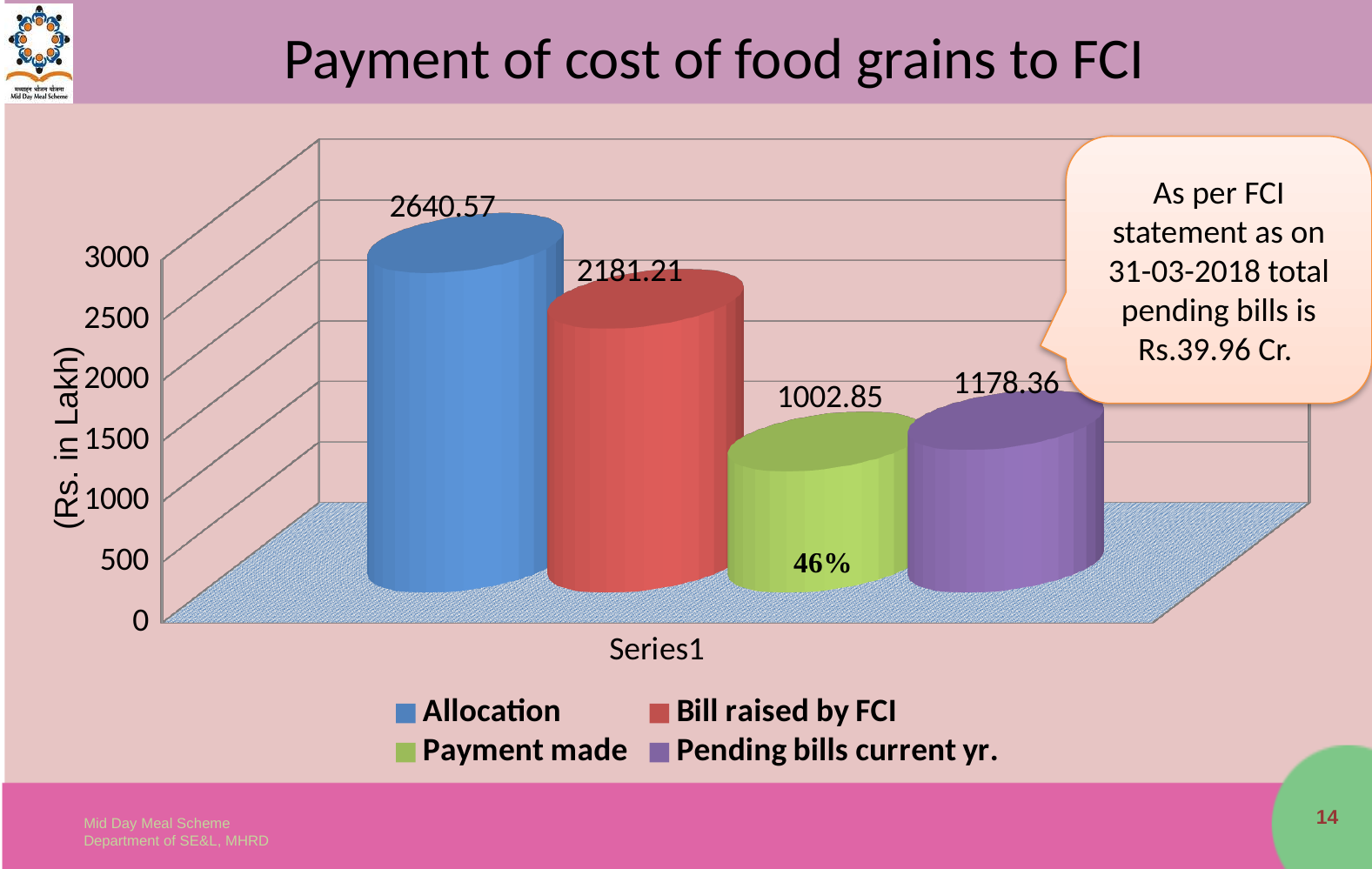
Which is larger, Pending bills current yr. or Payment made? Pending bills current yr. What is the value for Bill raised by FCI? 2181.21 What is the difference between Bill raised by FCI and Payment made? 1178.36 What kind of chart is shown on the slide? Bar chart What is the title of the chart? Payment of cost of food grains to FCI What is the value for Allocation? 2640.57 What is the value for Payment made? 1002.85 Which series has the lowest value? Payment made What is the value for Pending bills current yr.? 1178.36 How many series does the legend list? 4 What is the difference between Allocation and Bill raised by FCI? 459.36 Which series has the highest value? Allocation